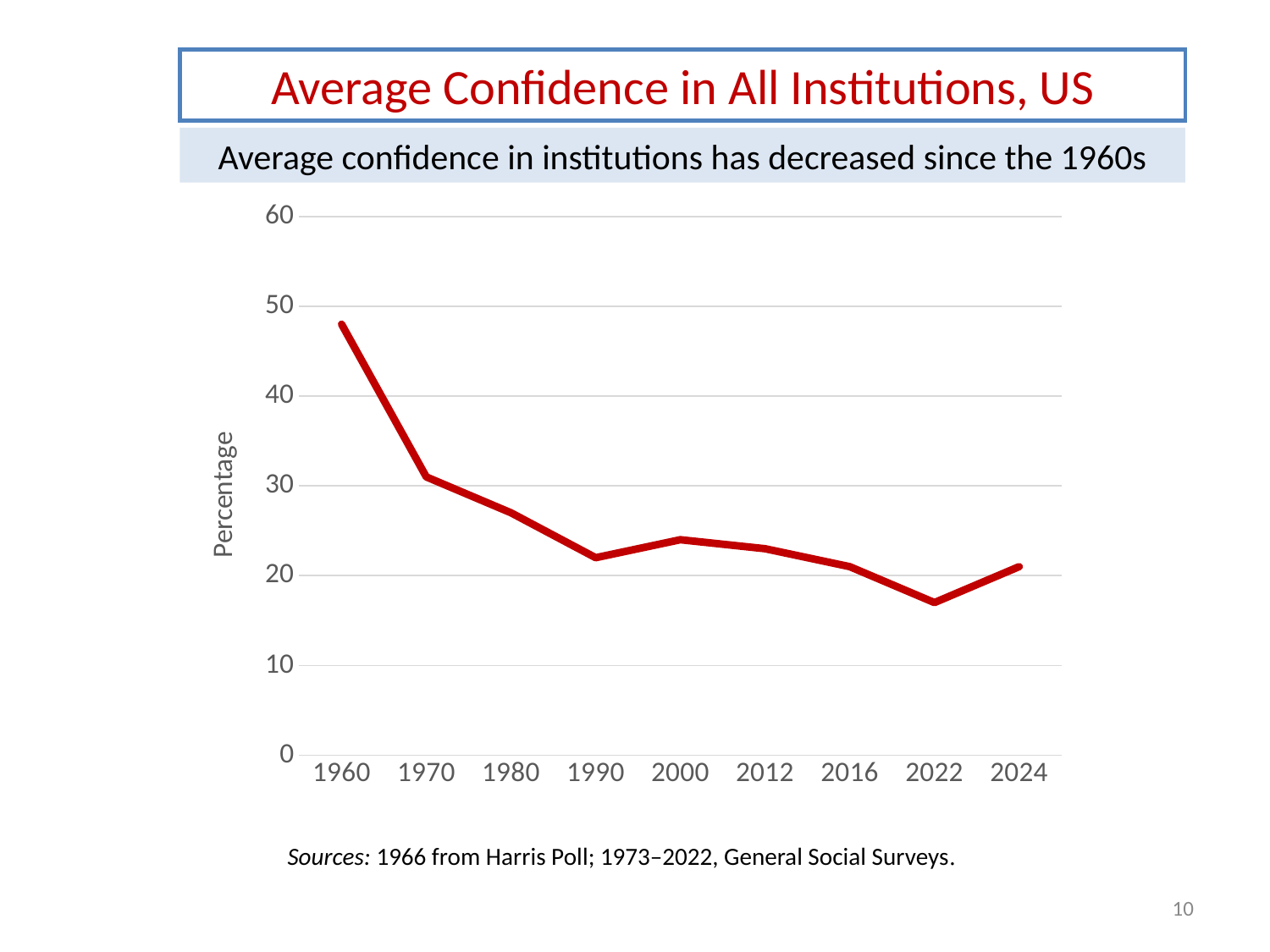
Is the value for 1980 greater or less than 30? less Which year has a higher value, 1960 or 1970? 1960 Which year has the lowest average confidence in all institutions? 2022 Is the value for 1960 greater or less than 40? greater Is the value for 2000 greater or less than 20? greater Which year has the highest average confidence in all institutions? 1960 Which year has a higher value, 1980 or 2016? 1980 What kind of chart is shown on the slide? line chart How many years are plotted on the x axis? 9 Overall, does average confidence rise or fall from 1960 to 2024? fall